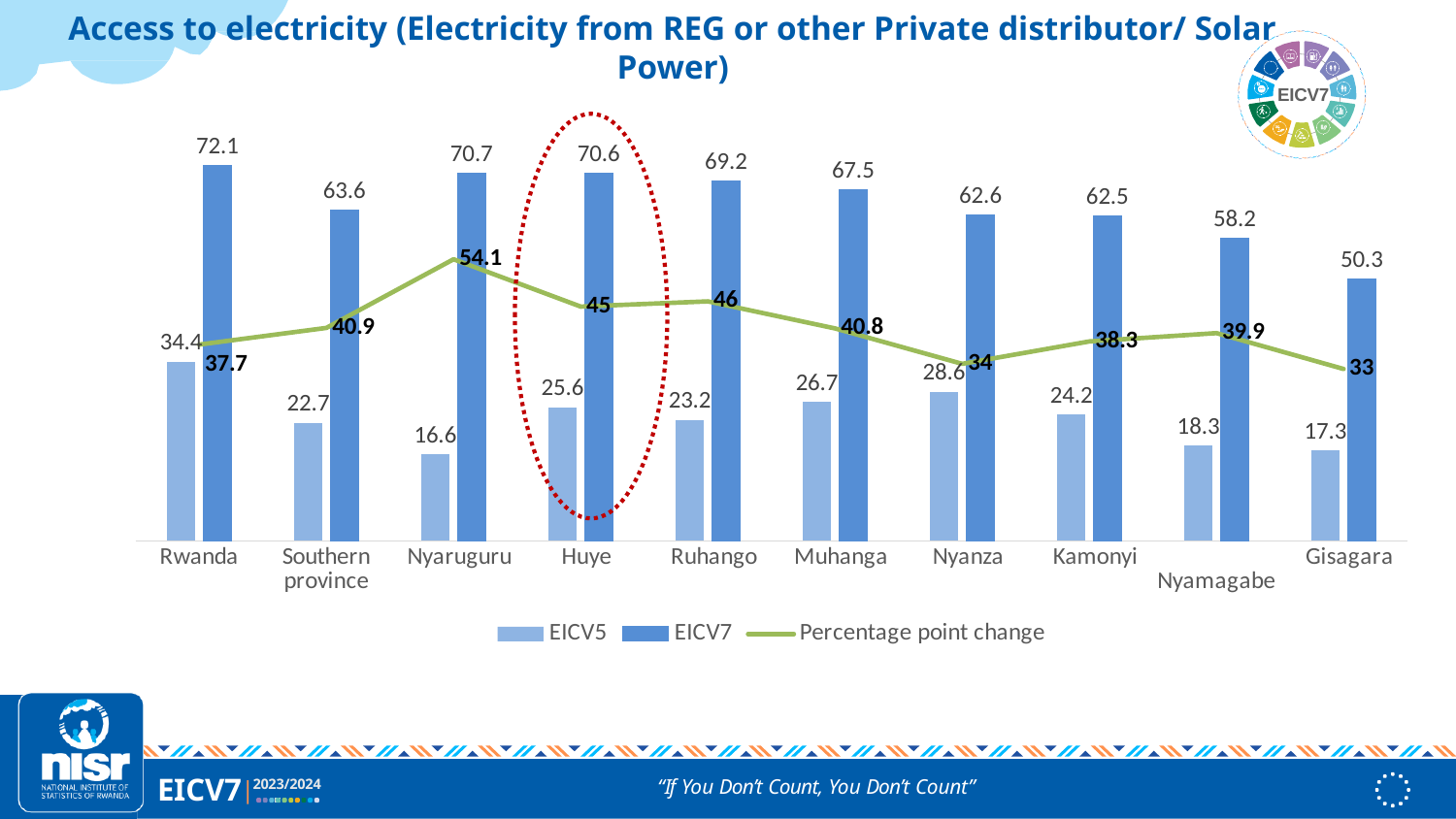
How many categories are shown on the x axis? 10 Which category has the highest EICV7 value? Rwanda Which category has the lowest percentage point change? Gisagara What is the EICV5 value for Rwanda? 34.4 How many series does the legend list? 3 Which category has the lowest EICV5 value? Nyaruguru What is the EICV5 value for Nyaruguru? 16.6 Which has a higher EICV7 value, Ruhango or Muhanga? Ruhango What is the percentage point change shown for Nyaruguru? 54.1 What kind of chart is this? Combination bar and line chart What is the difference between the EICV7 and EICV5 values for Gisagara? 33 What is the EICV7 value for Huye? 70.6